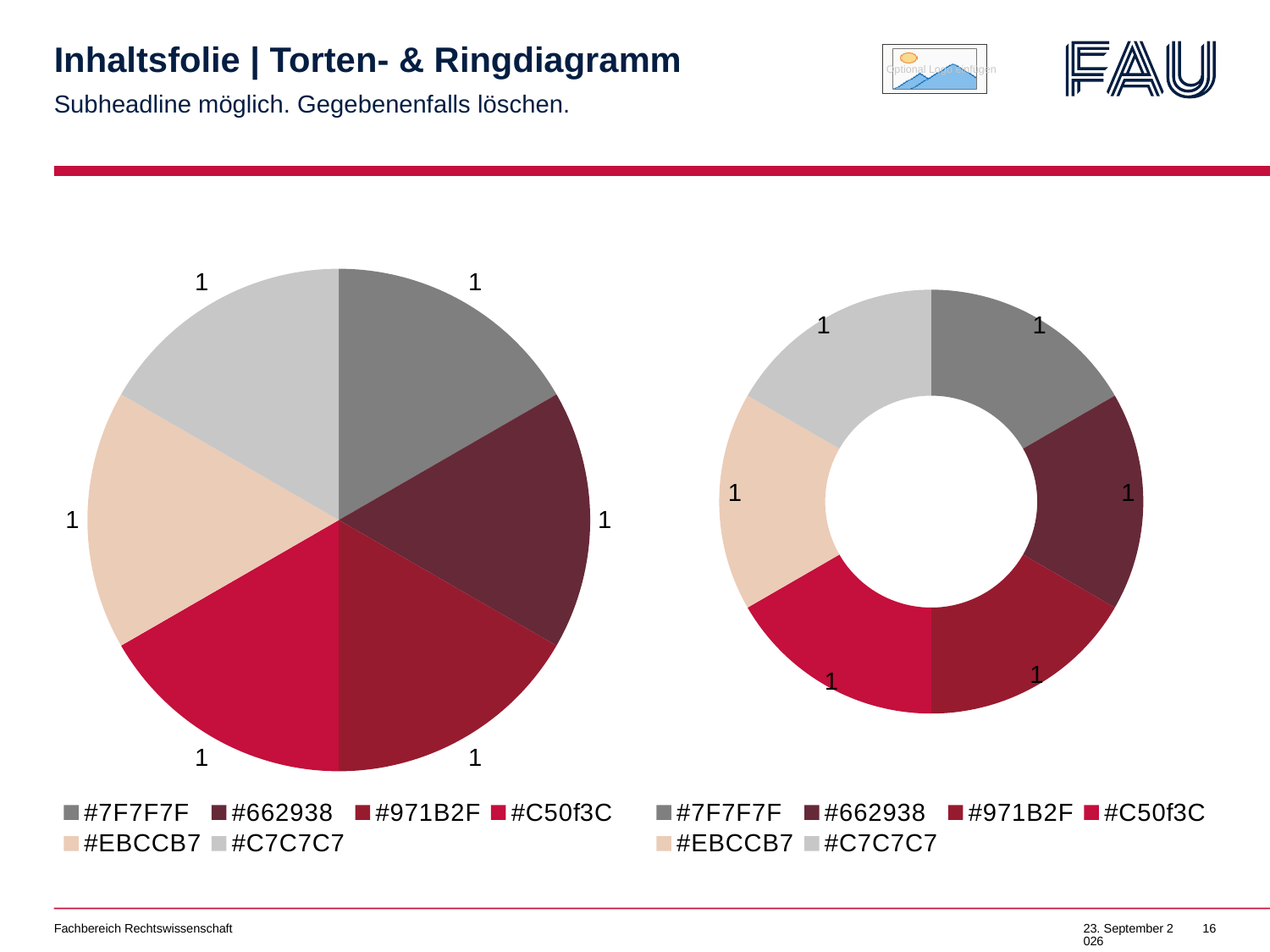
In the doughnut chart on the right, which legend entry corresponds to the lightest grey segment? #C7C7C7 What kind of chart is the chart on the right side of the slide? Doughnut chart In the pie chart on the left, what is the value of the #C50f3C slice? 1 In the pie chart on the left, what is the total of all slice values? 6 In the doughnut chart on the right, what is the value of the #EBCCB7 segment? 1 In the pie chart on the left, how many slices are there? 6 In the doughnut chart on the right, what is the total of all segment values? 6 How many entries does the legend of the pie chart on the left list? 6 In the pie chart on the left, what is the difference between the values of the #662938 slice and the #C7C7C7 slice? 0 What kind of chart is the chart on the left side of the slide? Pie chart In the doughnut chart on the right, how many segments are there? 6 In the pie chart on the left, what is the value of the #7F7F7F slice? 1